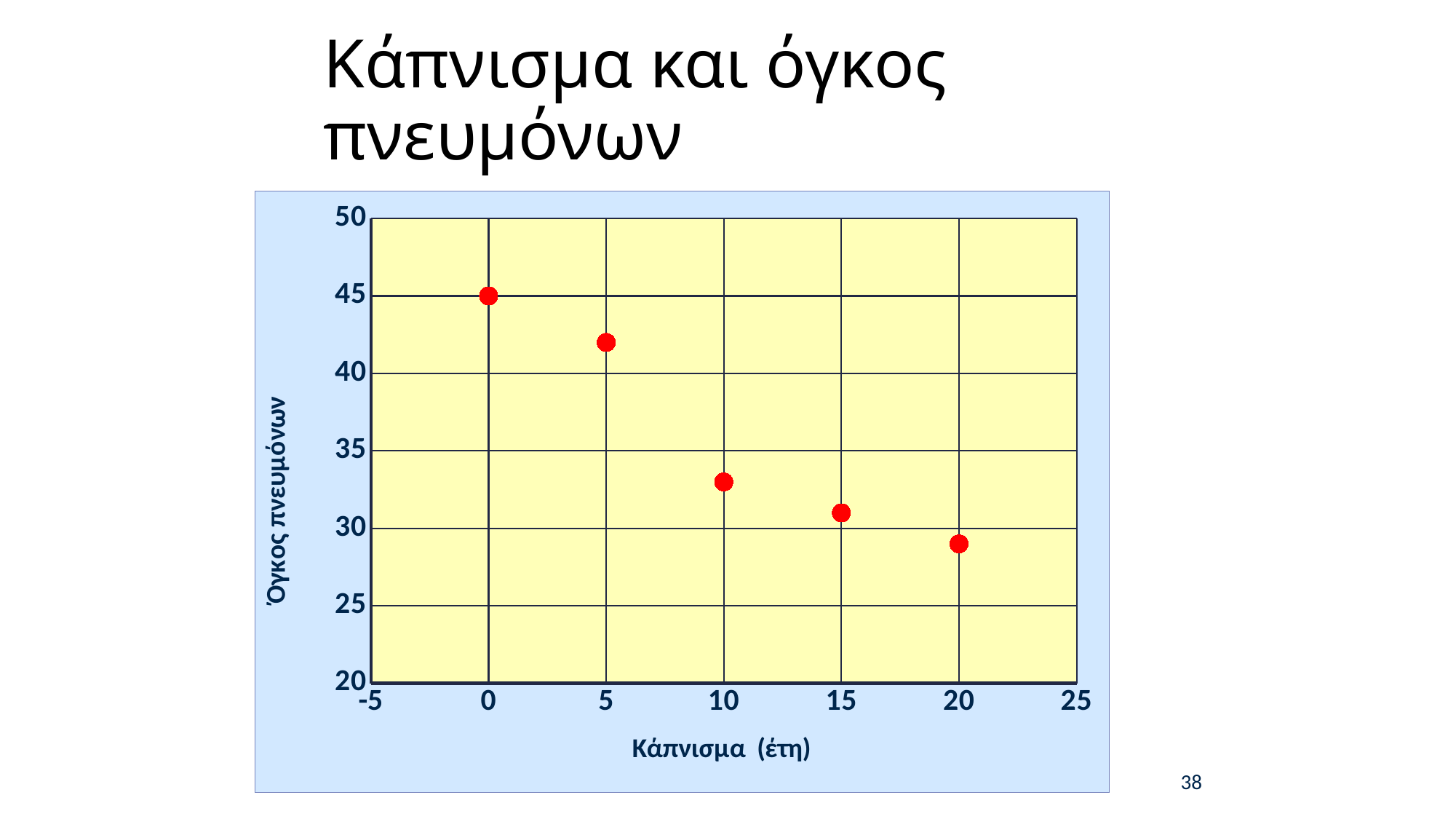
At which smoking duration (Κάπνισμα, έτη) is the lung volume lowest? 20 How many data points are plotted on the chart? 5 Is the lung volume value for 10 years of smoking greater or less than 35? less What is the lung volume (Όγκος πνευμόνων) value for 0 years of smoking? 45 Which has a larger lung volume value: 5 years of smoking or 15 years of smoking? 5 years What is the title of the slide? Κάπνισμα και όγκος πνευμόνων Is the lung volume value for 5 years of smoking greater or less than 40? greater What kind of chart is shown on the slide? scatter chart What is the label of the x axis of the chart? Κάπνισμα (έτη) At which smoking duration (Κάπνισμα, έτη) is the lung volume highest? 0 Do the lung volume values rise or fall as the years of smoking increase along the x axis? fall